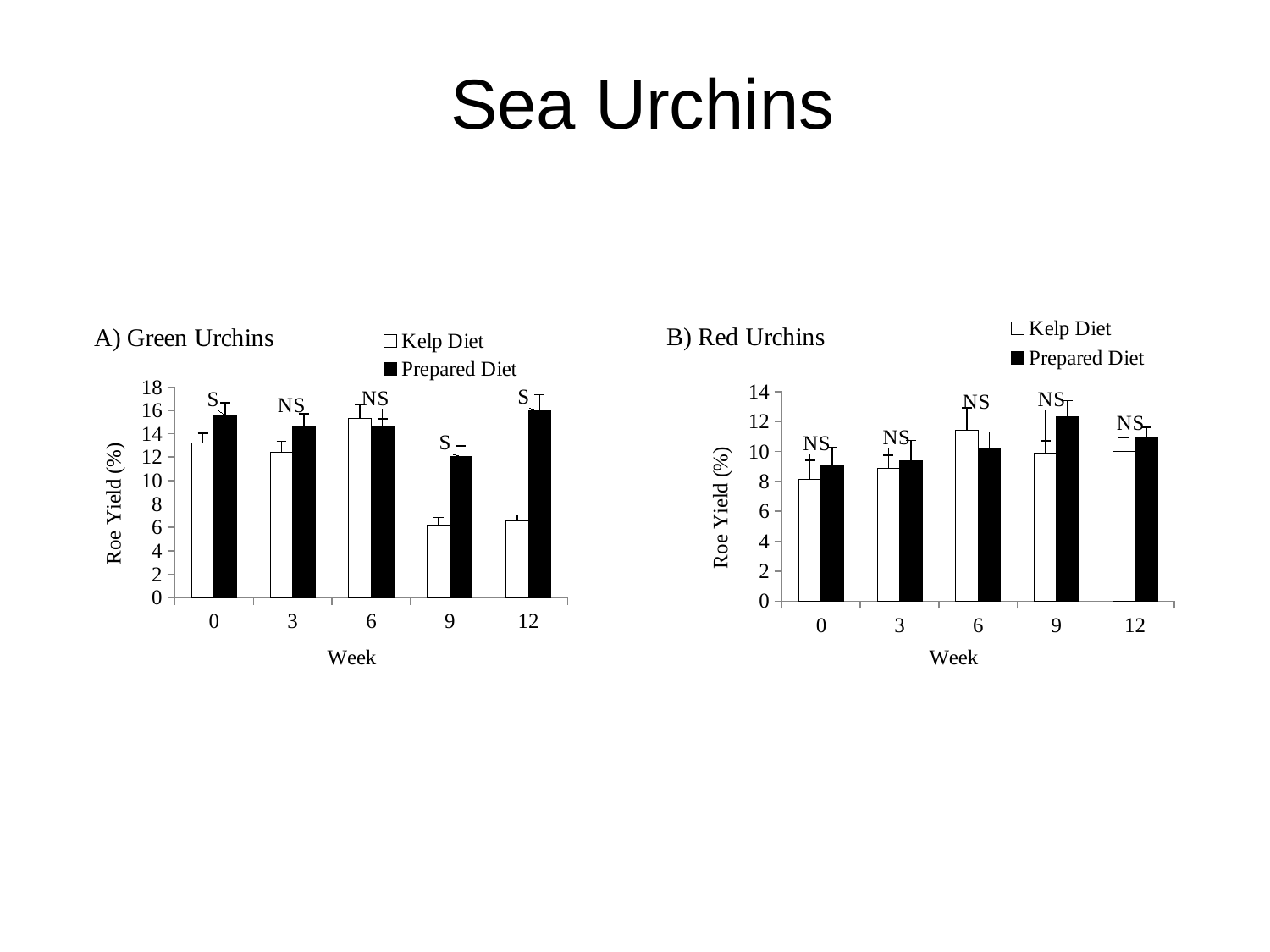
In A) Green Urchins, which diet has the larger roe yield at week 9? Prepared Diet How many series does the legend list for B) Red Urchins? 2 In B) Red Urchins, is the Kelp Diet value at week 0 greater or less than 10? less In B) Red Urchins, at which week is the Kelp Diet roe yield highest? 6 What kind of chart is used for A) Green Urchins? bar chart In B) Red Urchins, is the Prepared Diet value at week 9 greater or less than 10? greater In A) Green Urchins, is the Kelp Diet value at week 9 greater or less than 8? less In B) Red Urchins, which diet has the larger roe yield at week 9? Prepared Diet What is the y-axis label on the B) Red Urchins chart? Roe Yield (%) In B) Red Urchins, at which week is the Prepared Diet roe yield highest? 9 How many week categories are shown on the x axis of A) Green Urchins? 5